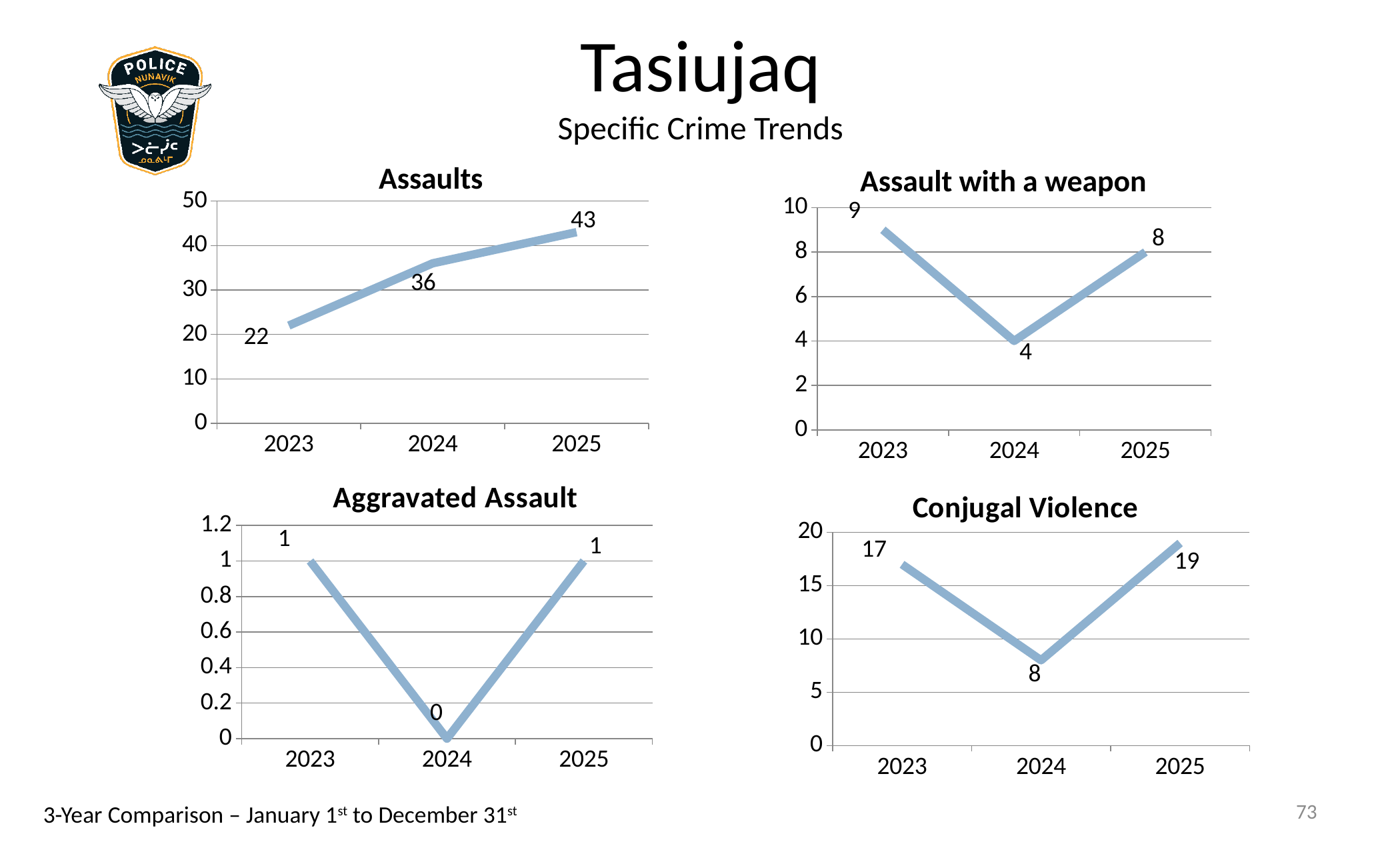
In the Conjugal Violence chart, what is the value for 2023? 17 In the Assault with a weapon chart, what is the value for 2024? 4 In the Conjugal Violence chart, what is the difference between the 2025 and 2024 values? 11 How many data points are plotted in the Aggravated Assault chart? 3 In the Assaults chart, what is the value for 2025? 43 In the Assaults chart, which year has the lowest value? 2023 In the Assault with a weapon chart, is the value for 2023 larger or the value for 2025? 2023 In the Assaults chart, do the values rise or fall from 2023 to 2025? rise In the Assault with a weapon chart, which year has the highest value? 2023 What kind of chart is the Conjugal Violence chart? line chart In the Aggravated Assault chart, what is the value for 2024? 0 In the Assaults chart, what is the difference between the 2025 and 2023 values? 21